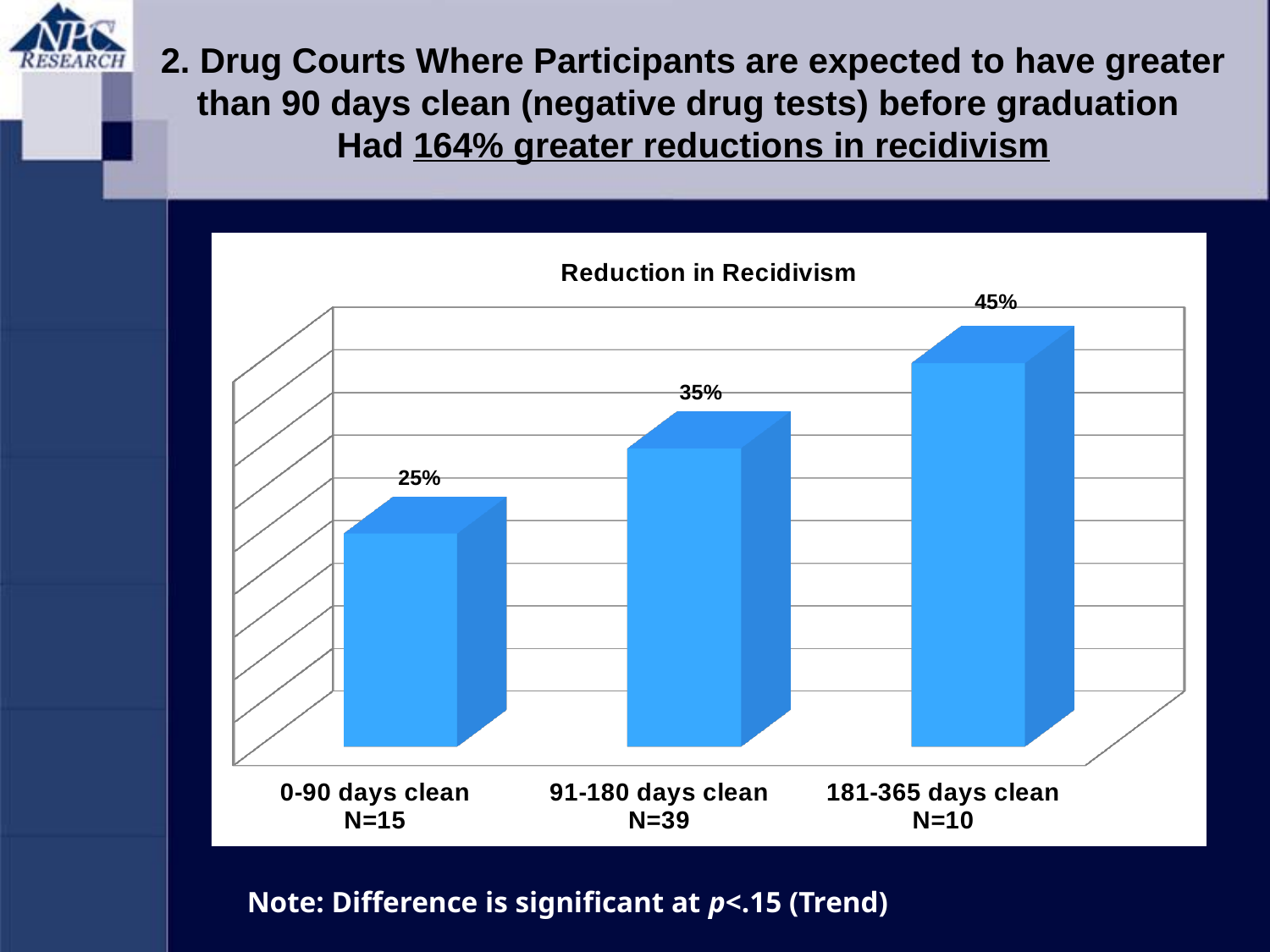
What is the title of the chart? Reduction in Recidivism Which category has the highest reduction in recidivism? 181-365 days clean What is the reduction in recidivism for drug courts with 91-180 days clean? 35% What is the reduction in recidivism for drug courts with 0-90 days clean? 25% Which category has the lowest reduction in recidivism? 0-90 days clean What is the difference in reduction in recidivism between 91-180 days clean and 0-90 days clean? 10% What is the difference in reduction in recidivism between 181-365 days clean and 0-90 days clean? 20% How many categories are shown in the chart? 3 Do the values rise or fall as the number of days clean increases along the x axis? Rise Which has a larger reduction in recidivism: 91-180 days clean or 181-365 days clean? 181-365 days clean What is the reduction in recidivism for drug courts with 181-365 days clean? 45% What kind of chart is shown on the slide? Bar chart